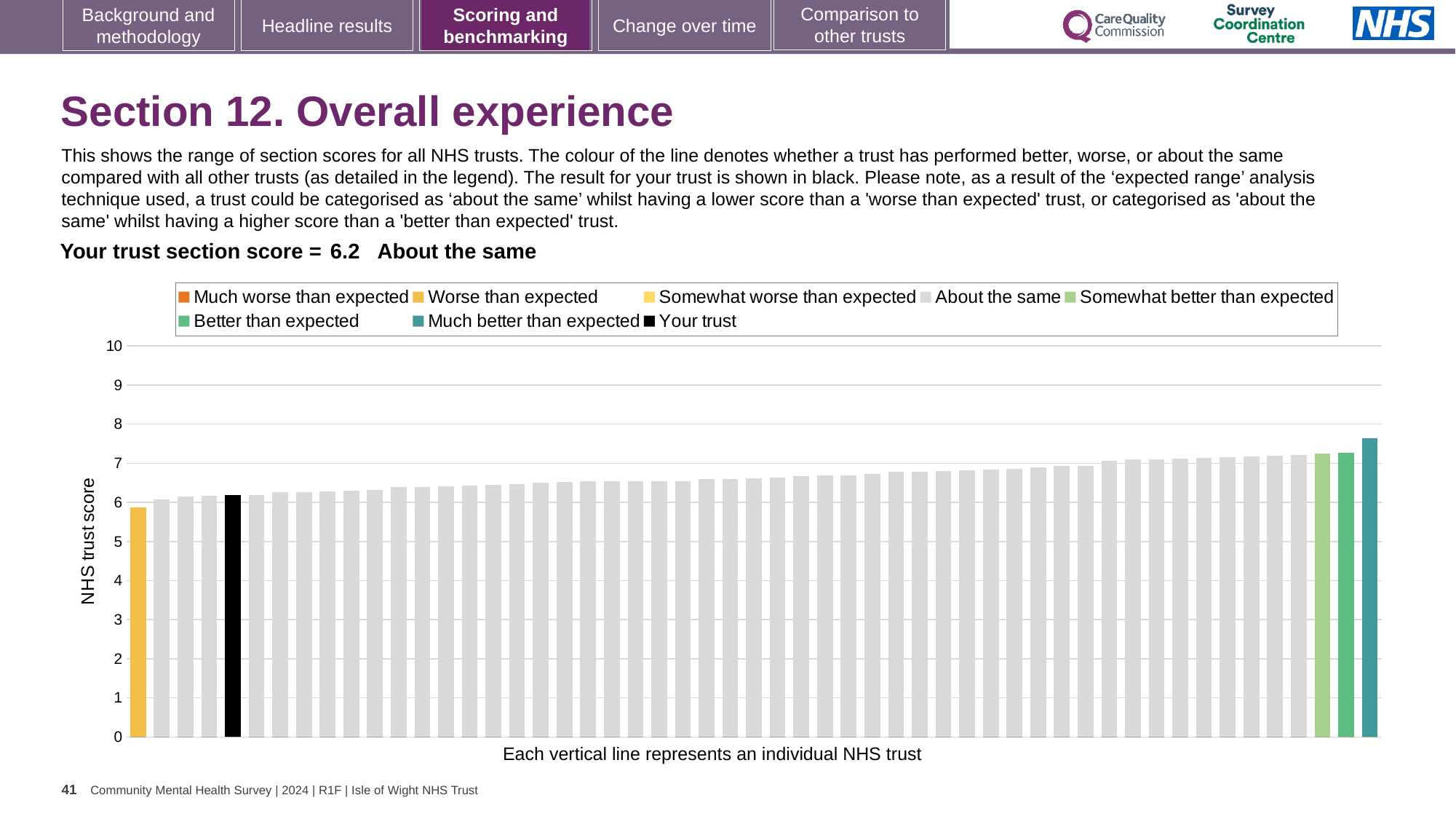
Do the bar values rise or fall from left to right along the x axis? rise Is the tallest bar in the chart greater or less than 8? less What is the section score for your trust shown on the slide? 6.2 Is the value for your trust greater or less than 7? less What kind of chart is shown on the slide? bar chart What colour is the bar representing your trust? black Is the tallest bar in the chart greater or less than 7? greater Which legend category does the shortest bar in the chart belong to? Worse than expected How many entries does the chart legend list? 8 What is the label on the vertical axis of the chart? NHS trust score Which legend category does the tallest bar in the chart belong to? Much better than expected